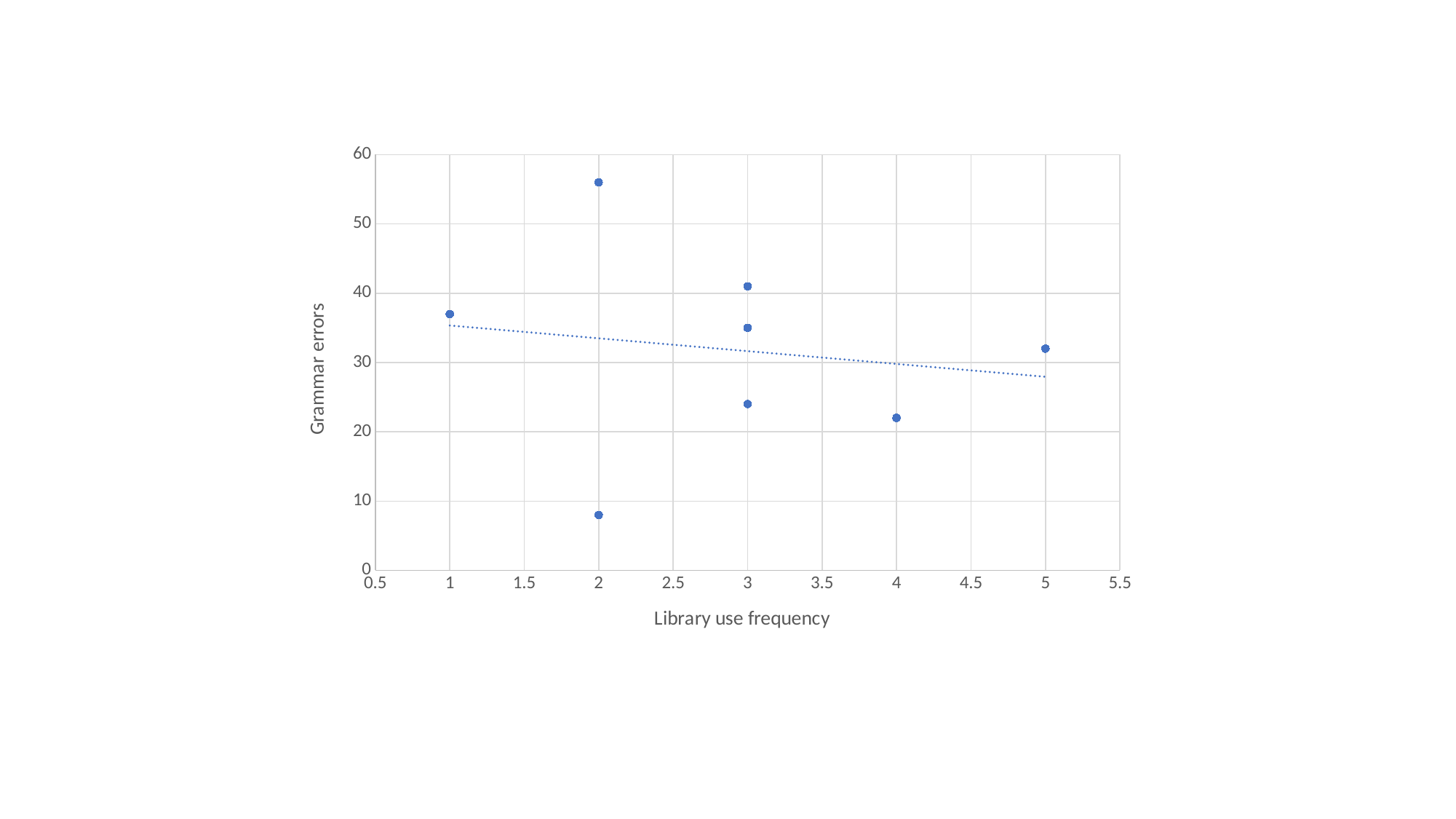
Which has more grammar errors: the point at library use frequency 1 or the point at library use frequency 4? library use frequency 1 What is the title of the x axis? Library use frequency How many data points are plotted on the chart? 8 At which library use frequency is the point with the lowest number of grammar errors? 2 How many data points are plotted at a library use frequency of 3? 3 What is the title of the y axis? Grammar errors Is the grammar errors value for the point at library use frequency 4 greater or less than 30? less At which library use frequency is the point with the highest number of grammar errors? 2 Does the dotted trendline rise or fall as library use frequency increases? fall Is the grammar errors value for the point at library use frequency 1 greater or less than 40? less Is the grammar errors value for the highest point at library use frequency 2 greater or less than 50? greater What kind of chart is shown on the slide? scatter chart